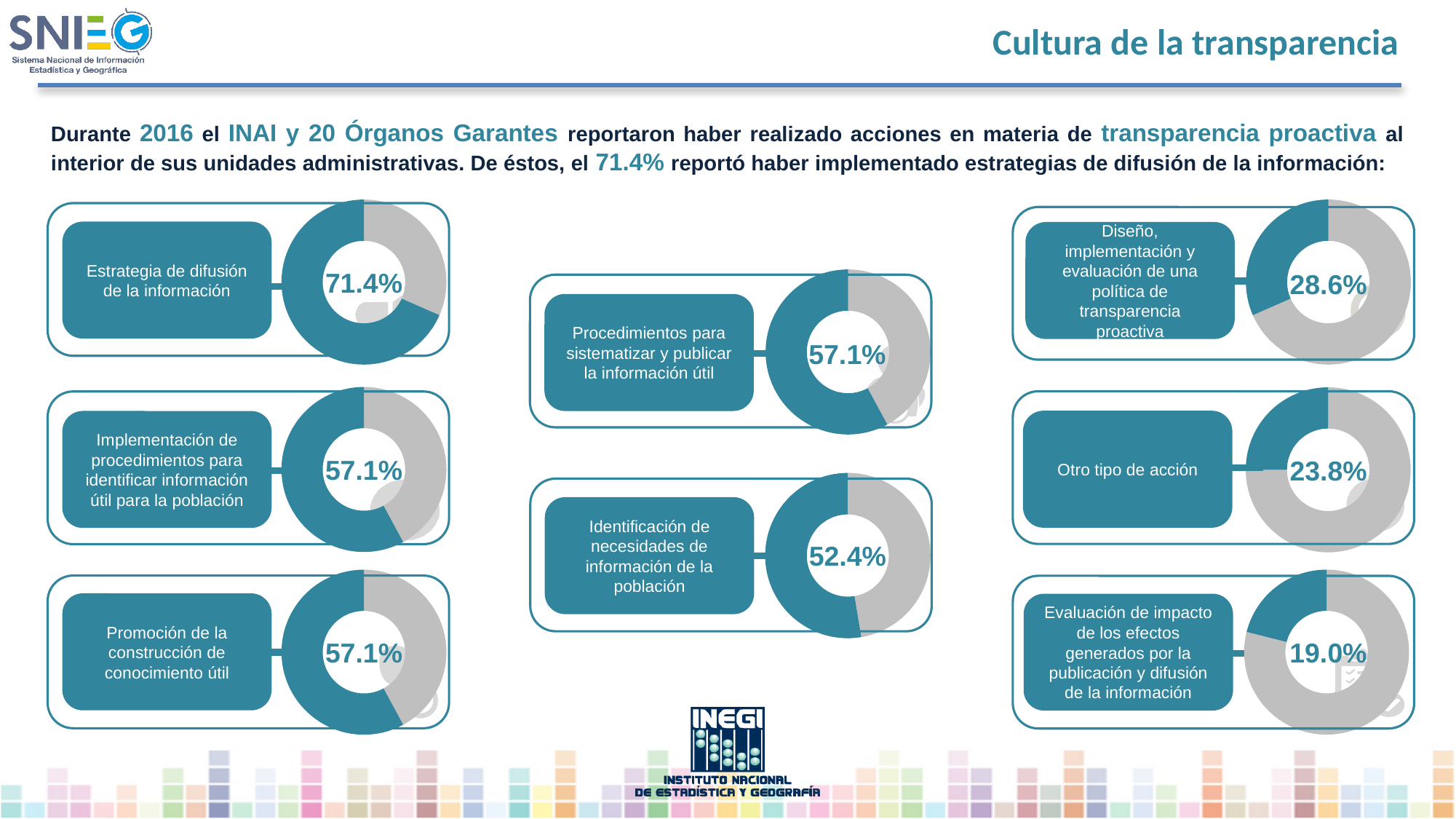
How many donut charts are shown on the slide? 8 What percentage is shown in the donut chart for "Estrategia de difusión de la información"? 71.4% What kind of chart is used to display each percentage on the slide? Donut chart What is the difference between the percentage for "Estrategia de difusión de la información" and the percentage for "Otro tipo de acción"? 47.6% What percentage is shown in the donut chart for "Evaluación de impacto de los efectos generados por la publicación y difusión de la información"? 19.0% Which is larger: the percentage for "Procedimientos para sistematizar y publicar la información útil" or the percentage for "Identificación de necesidades de información de la población"? Procedimientos para sistematizar y publicar la información útil Which action has the lowest percentage among the donut charts on the slide? Evaluación de impacto de los efectos generados por la publicación y difusión de la información What percentage is shown in the donut chart for "Diseño, implementación y evaluación de una política de transparencia proactiva"? 28.6% Which action has the highest percentage among the donut charts on the slide? Estrategia de difusión de la información What percentage is shown in the donut chart for "Identificación de necesidades de información de la población"? 52.4% How many of the donut charts on the slide show a value of 57.1%? 3 What percentage is shown in the donut chart for "Otro tipo de acción"? 23.8%